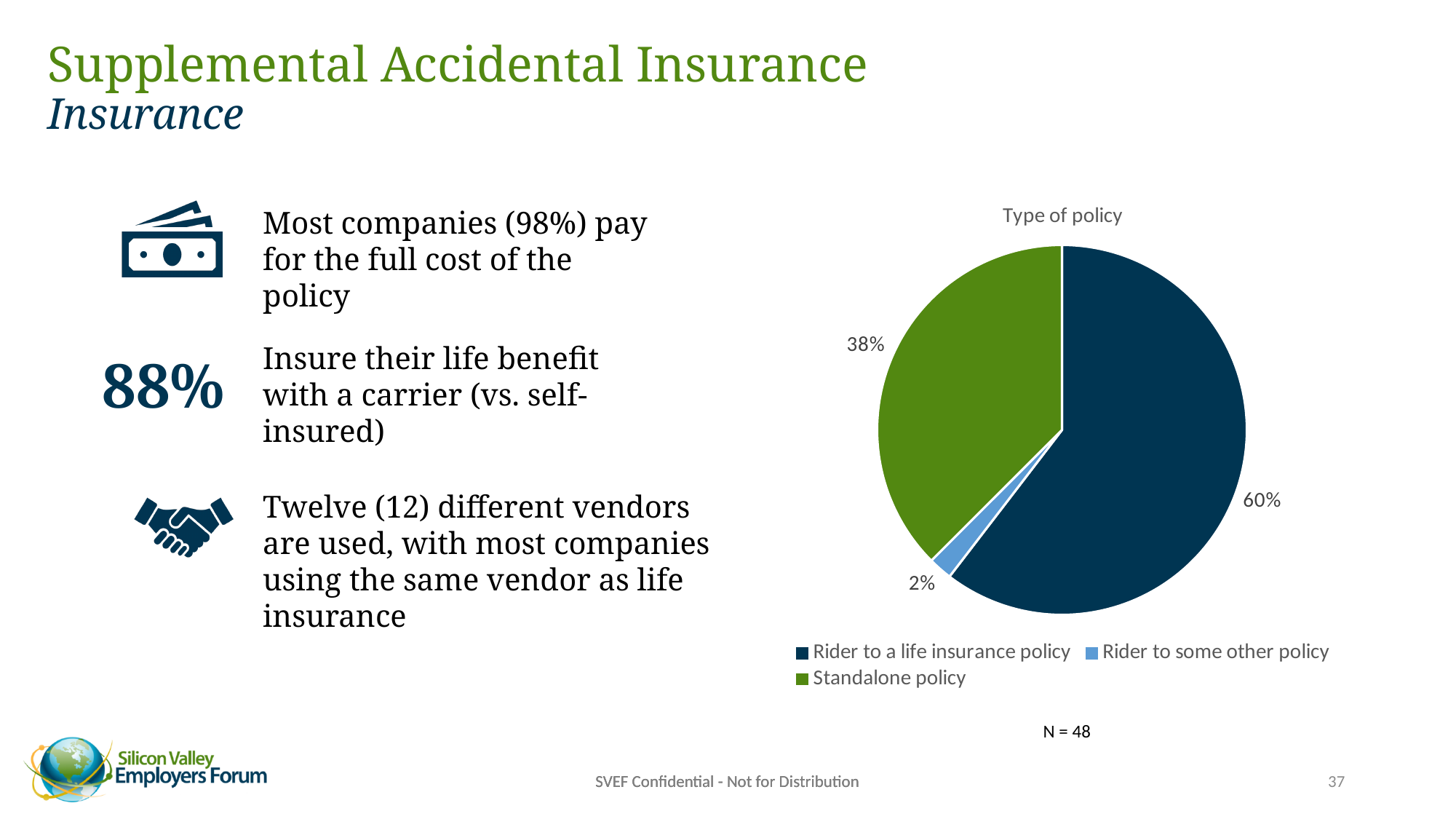
Which type of policy has the largest share of the pie? Rider to a life insurance policy What share of the pie is 'Rider to some other policy'? 2% What share of the pie is 'Rider to a life insurance policy'? 60% Which is larger: the share for 'Standalone policy' or the share for 'Rider to some other policy'? Standalone policy What colour is the 'Standalone policy' slice? Green What is the sample size (N) shown below the chart? N = 48 Which type of policy has the smallest share of the pie? Rider to some other policy How many slices does the pie chart have? 3 What is the difference in percentage points between 'Rider to a life insurance policy' and 'Standalone policy'? 22 percentage points What share of the pie is 'Standalone policy'? 38% What kind of chart is shown on the slide? Pie chart What is the title of the chart? Type of policy